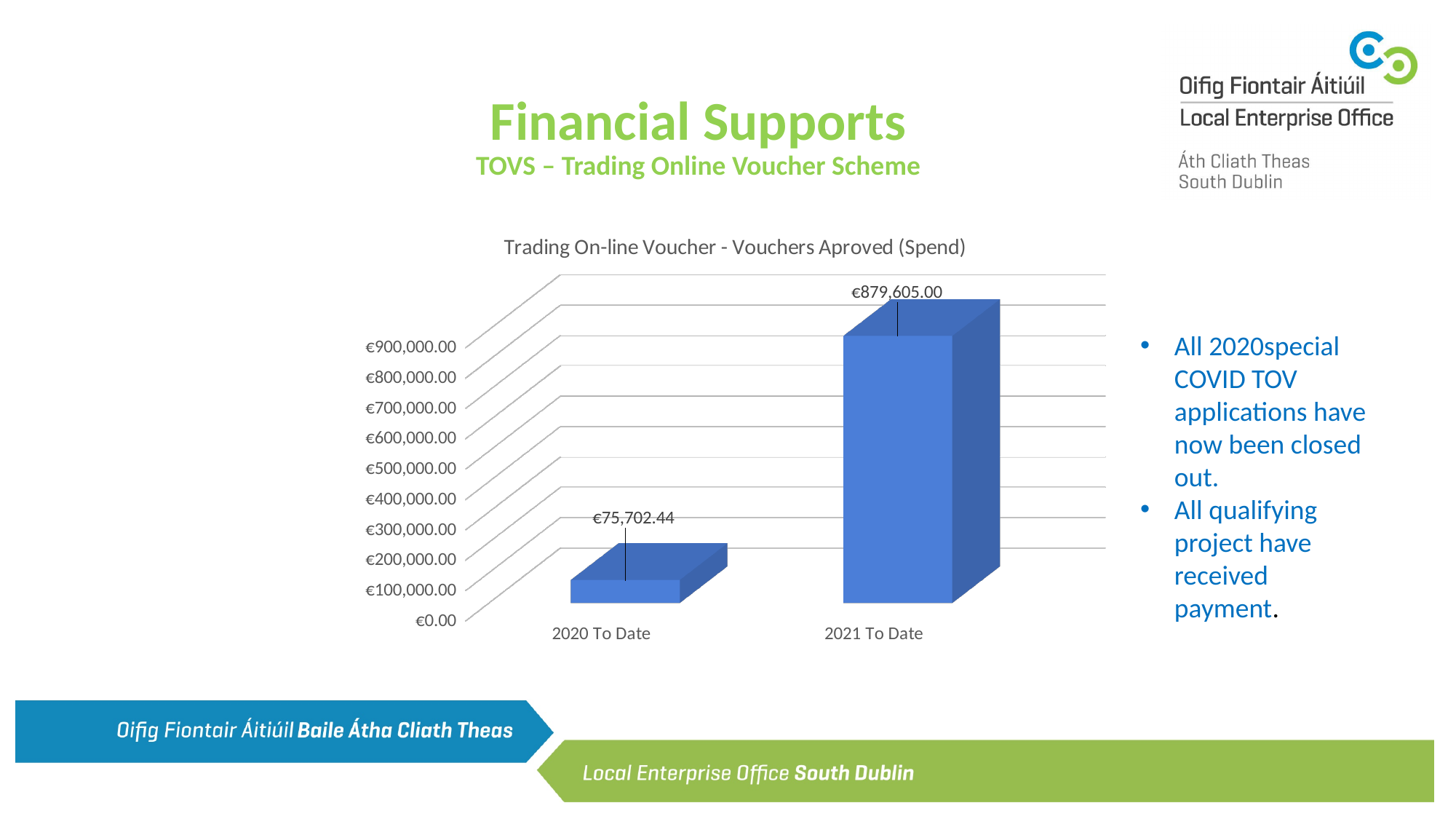
Which category has the lowest value? 2020 To Date What is the title of the chart? Trading On-line Voucher - Vouchers Aproved (Spend) Do the values rise or fall from 2020 To Date to 2021 To Date? Rise How many categories are shown on the x axis? 2 What is the value for 2021 To Date? €879,605.00 Is the value for 2021 To Date greater or less than €800,000.00? greater Which category has the highest value? 2021 To Date What is the difference between the values for 2021 To Date and 2020 To Date? €803,902.56 Which is larger, the value for 2020 To Date or the value for 2021 To Date? 2021 To Date What kind of chart is shown on the slide? Bar chart Is the value for 2020 To Date greater or less than €100,000.00? less What is the value for 2020 To Date? €75,702.44